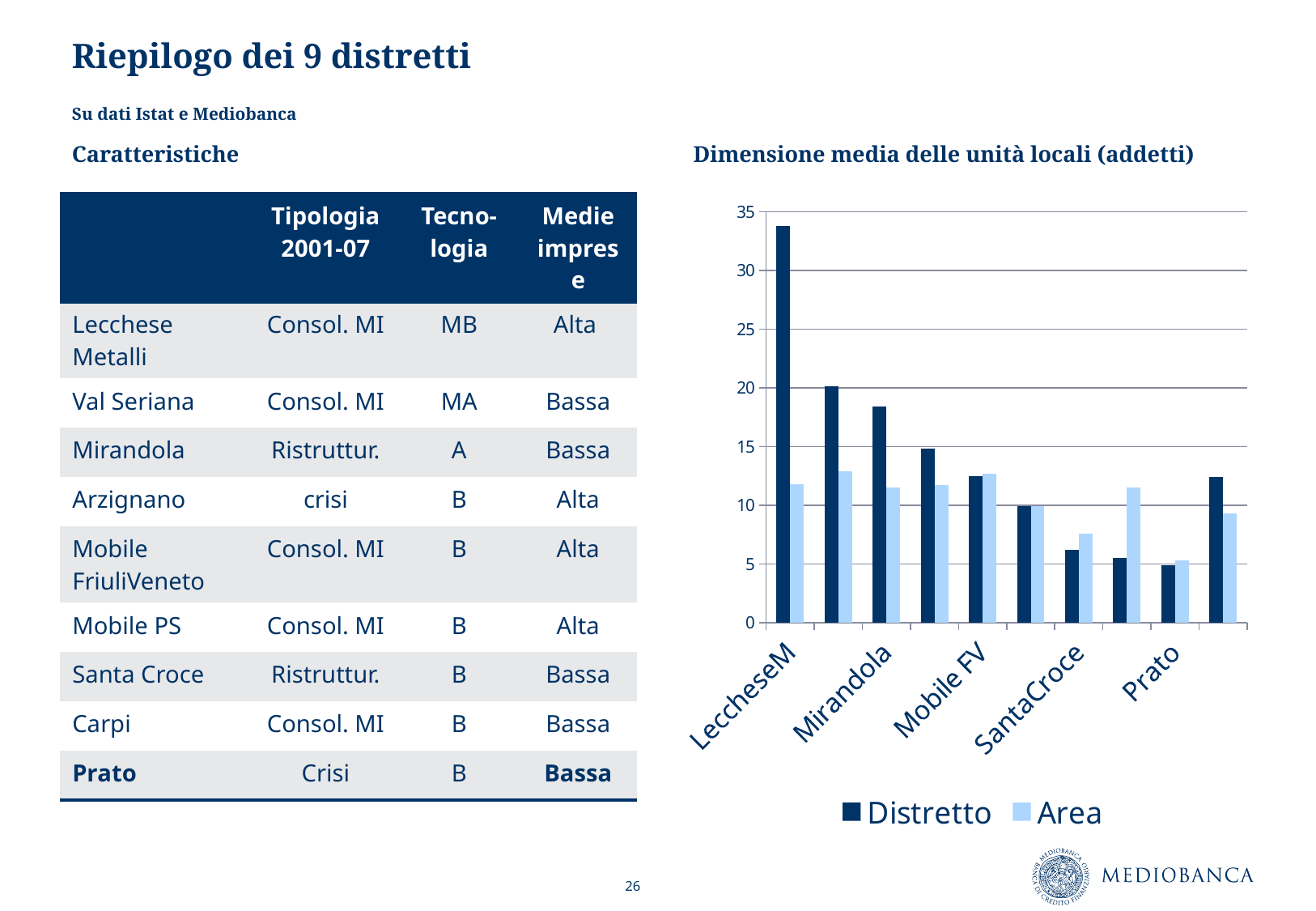
Which category has the highest Distretto value? LeccheseM For SantaCroce, which is larger: the Distretto value or the Area value? Area For LeccheseM, which is larger: the Distretto value or the Area value? Distretto Is the Area value for SantaCroce greater or less than 10? less What is the title of the chart? Dimensione media delle unità locali (addetti) What are the two series named in the chart legend? Distretto and Area Do the Distretto values generally rise or fall from LeccheseM to Prato along the x axis? fall What kind of chart is shown on the slide? bar chart How many series does the chart legend list? 2 Is the Distretto value for Mirandola greater or less than 15? greater Is the Distretto value for Prato greater or less than 10? less